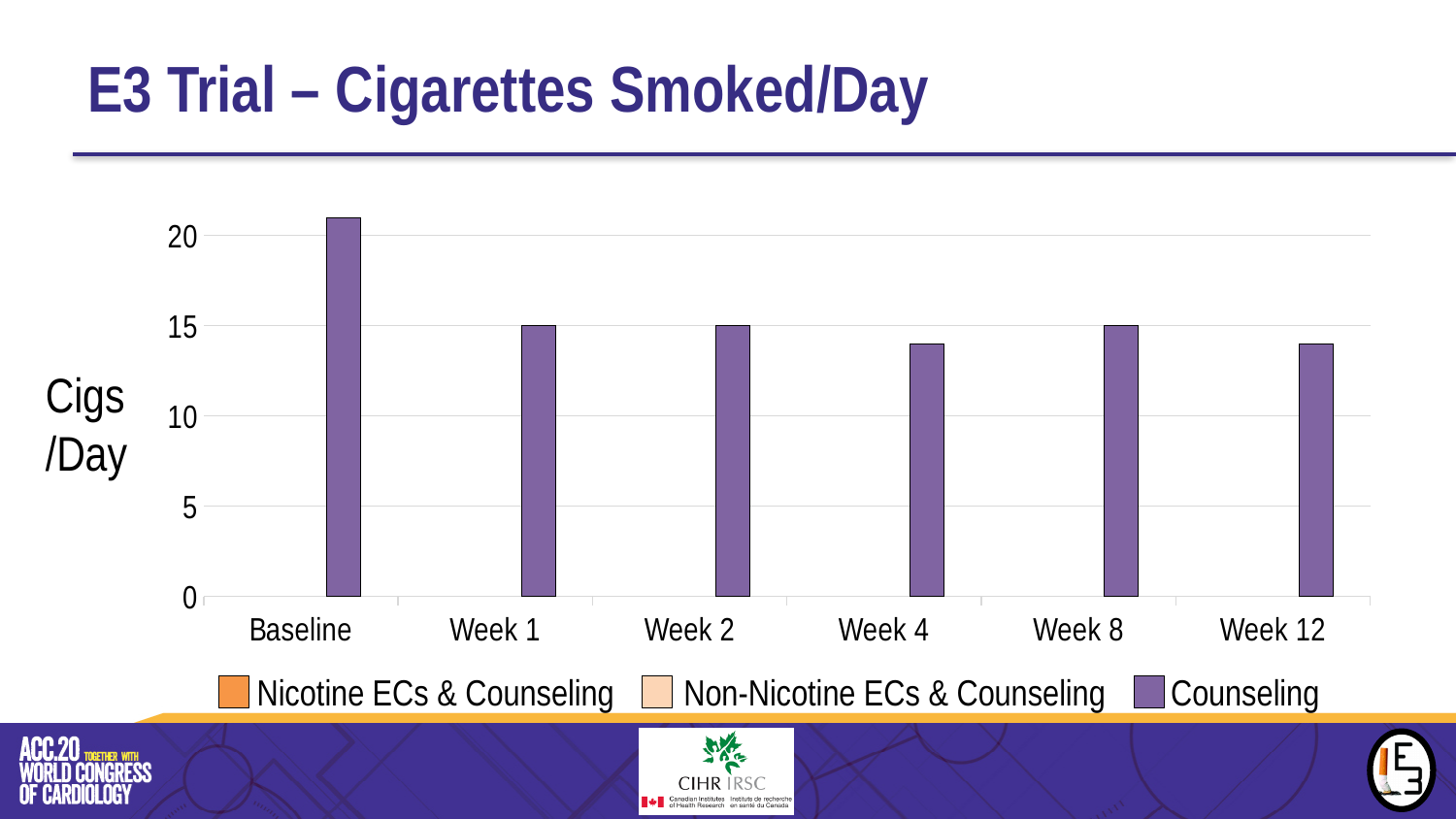
Which is larger, the Counseling value at Baseline or at Week 2? Baseline How many categories are shown on the x axis? 6 Which category has the highest value for Counseling? Baseline Is the Counseling value at Baseline greater or less than 20? greater Do the Counseling values rise or fall from Baseline to Week 1? fall Is the Counseling value at Week 4 greater or less than 15? less How many series does the legend list? 3 What is the title of the chart? E3 Trial – Cigarettes Smoked/Day What type of chart is shown on the slide? bar chart What is the Counseling value at Week 1? 15 What is the Counseling value at Week 8? 15 Is the Counseling value at Week 12 greater or less than 10? greater